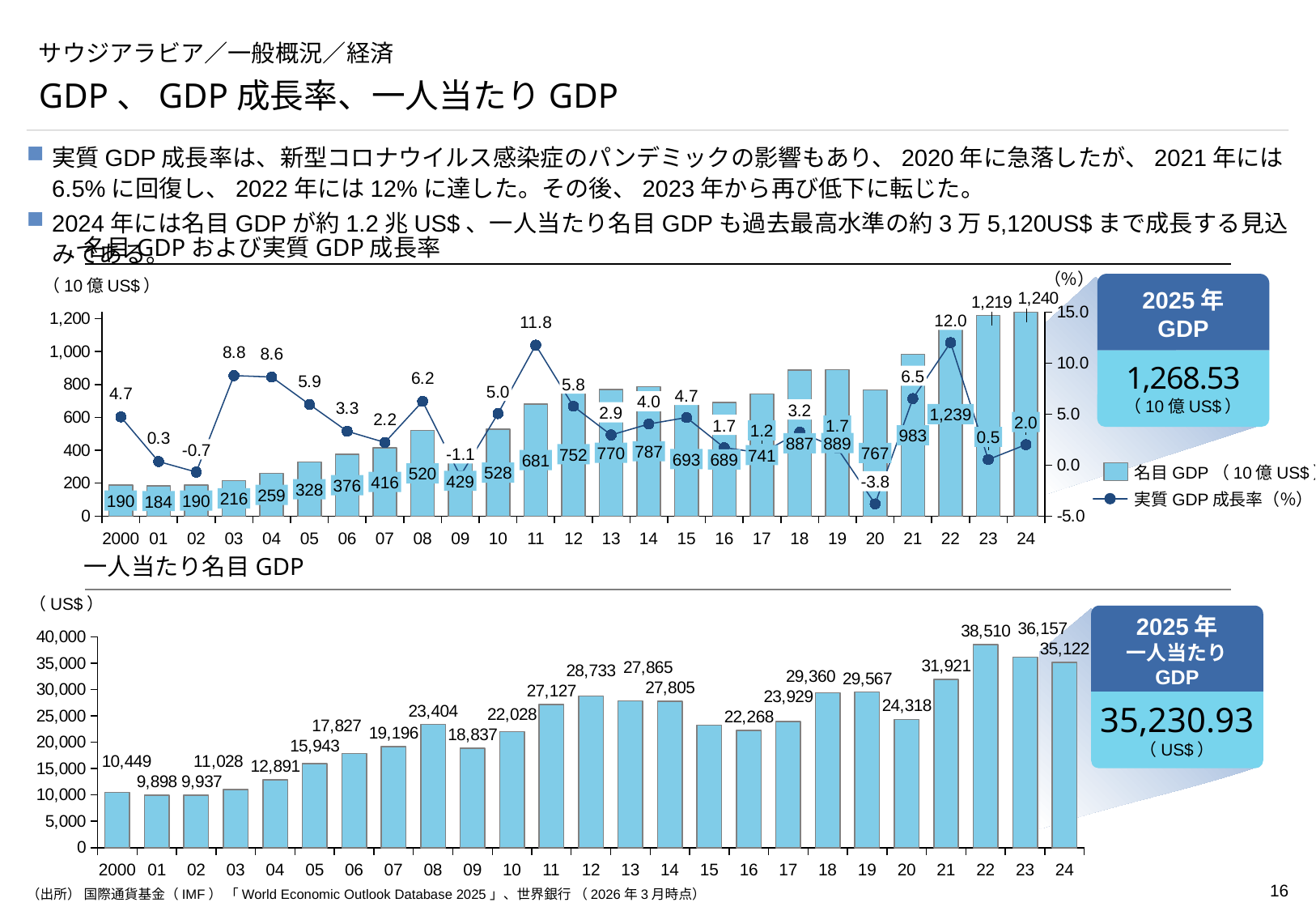
In the bottom chart, what is the difference between the values for 2023 and 2024? 1,035 In the top chart, what is the real GDP growth rate for 2020? -3.8 In the bottom chart, do the values rise or fall from 2000 to 2008? rise In the top chart, what is the difference between the nominal GDP for 2021 and for 2020? 216 What kind of chart is the bottom chart (一人当たり名目GDP)? bar chart How many series does the legend of the top chart list? 2 In the bottom chart (一人当たり名目GDP), what is the value for 2022? 38,510 In the top chart (名目GDPおよび実質GDP成長率), what is the nominal GDP value for 2008? 520 In the bottom chart, which year has the highest per-capita nominal GDP? 2022 In the top chart, what is the real GDP growth rate for 2011? 11.8 In the top chart, which is larger, the nominal GDP for 2013 or for 2014? 2014 In the top chart, which year has the lowest real GDP growth rate? 2020